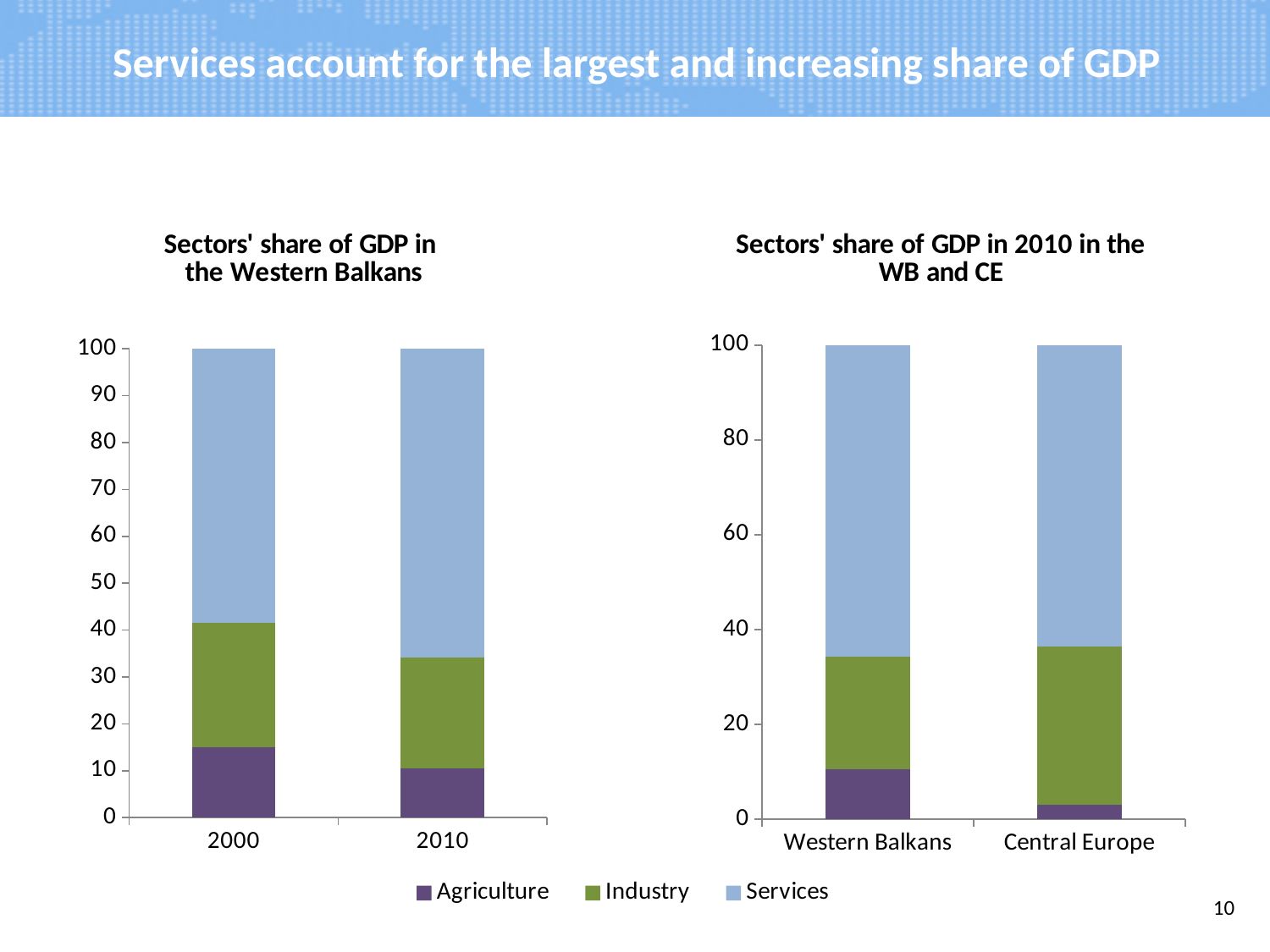
In the 'Sectors' share of GDP in 2010 in the WB and CE' chart, how many regions are shown on the x axis? 2 In the 'Sectors' share of GDP in the Western Balkans' chart, how many years are shown on the x axis? 2 In the 'Sectors' share of GDP in the Western Balkans' chart, is the Agriculture value for 2000 greater or less than 10? greater In the 'Sectors' share of GDP in the Western Balkans' chart, what is the total of the stacked bar for 2000? 100 In the 'Sectors' share of GDP in 2010 in the WB and CE' chart, is the Agriculture value for Central Europe greater or less than 20? less In the 'Sectors' share of GDP in the Western Balkans' chart, is the Agriculture share larger in 2000 or in 2010? 2000 In the 'Sectors' share of GDP in 2010 in the WB and CE' chart, which region has the larger Industry share, Western Balkans or Central Europe? Central Europe In the 'Sectors' share of GDP in the Western Balkans' chart, does the Agriculture share rise or fall from 2000 to 2010? fall In the 'Sectors' share of GDP in the Western Balkans' chart, is the Agriculture value for 2010 greater or less than 20? less What kind of chart is the 'Sectors' share of GDP in the Western Balkans' chart? Stacked bar chart How many series does the legend list? 3 In the 'Sectors' share of GDP in 2010 in the WB and CE' chart, which region has the larger Agriculture share, Western Balkans or Central Europe? Western Balkans